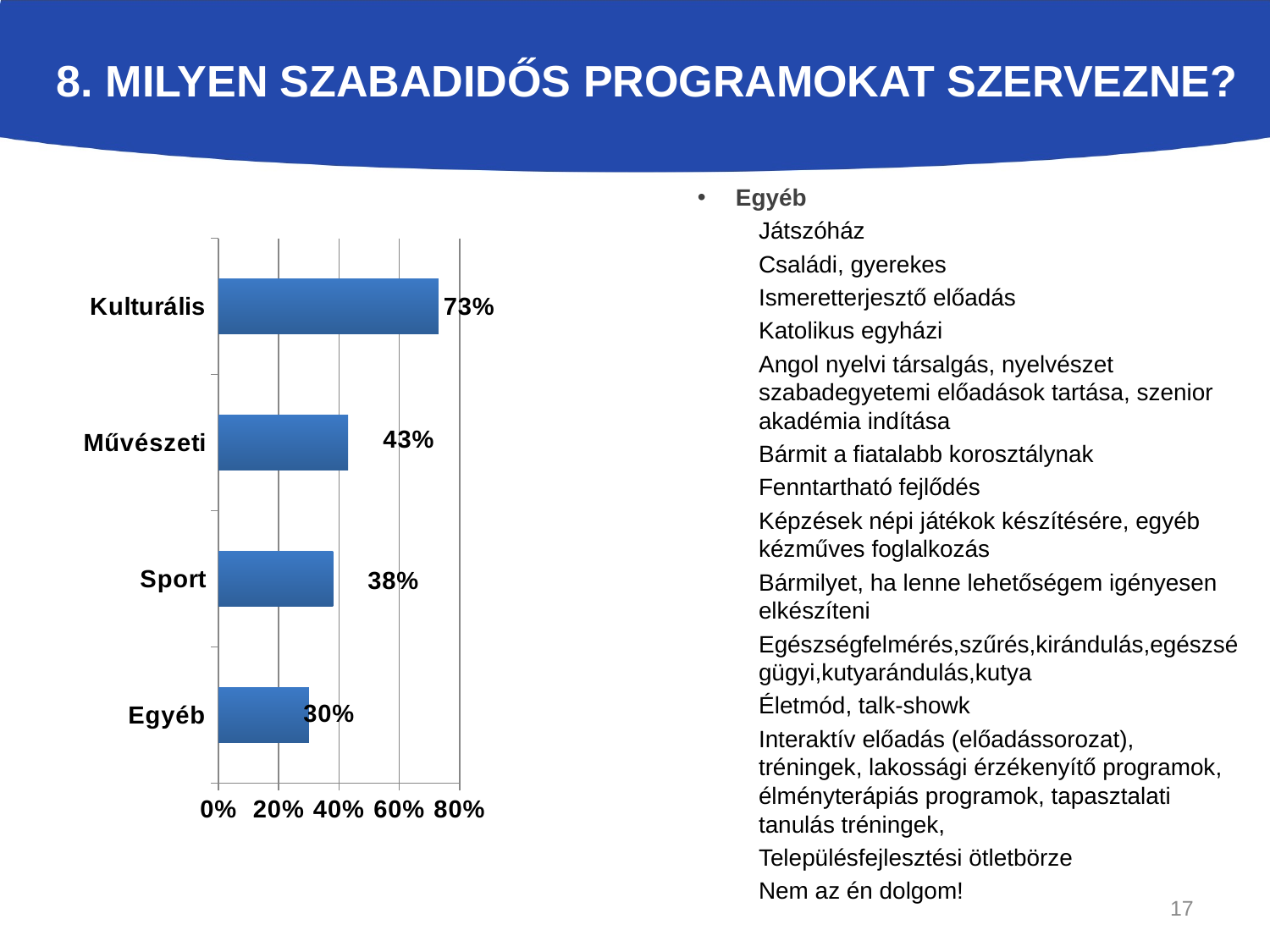
What is the difference between the values for Kulturális and Művészeti? 30% What is the value for Művészeti? 43% What is the value for Egyéb? 30% What kind of chart is shown on the slide? bar chart Which category has the lowest value? Egyéb Which category has the highest value? Kulturális What is the value for Sport? 38% What is the difference between the values for Sport and Egyéb? 8% Which is larger, the value for Művészeti or the value for Sport? Művészeti Is the value for Kulturális greater or less than 60%? greater How many categories are shown in the chart? 4 What is the value for Kulturális? 73%